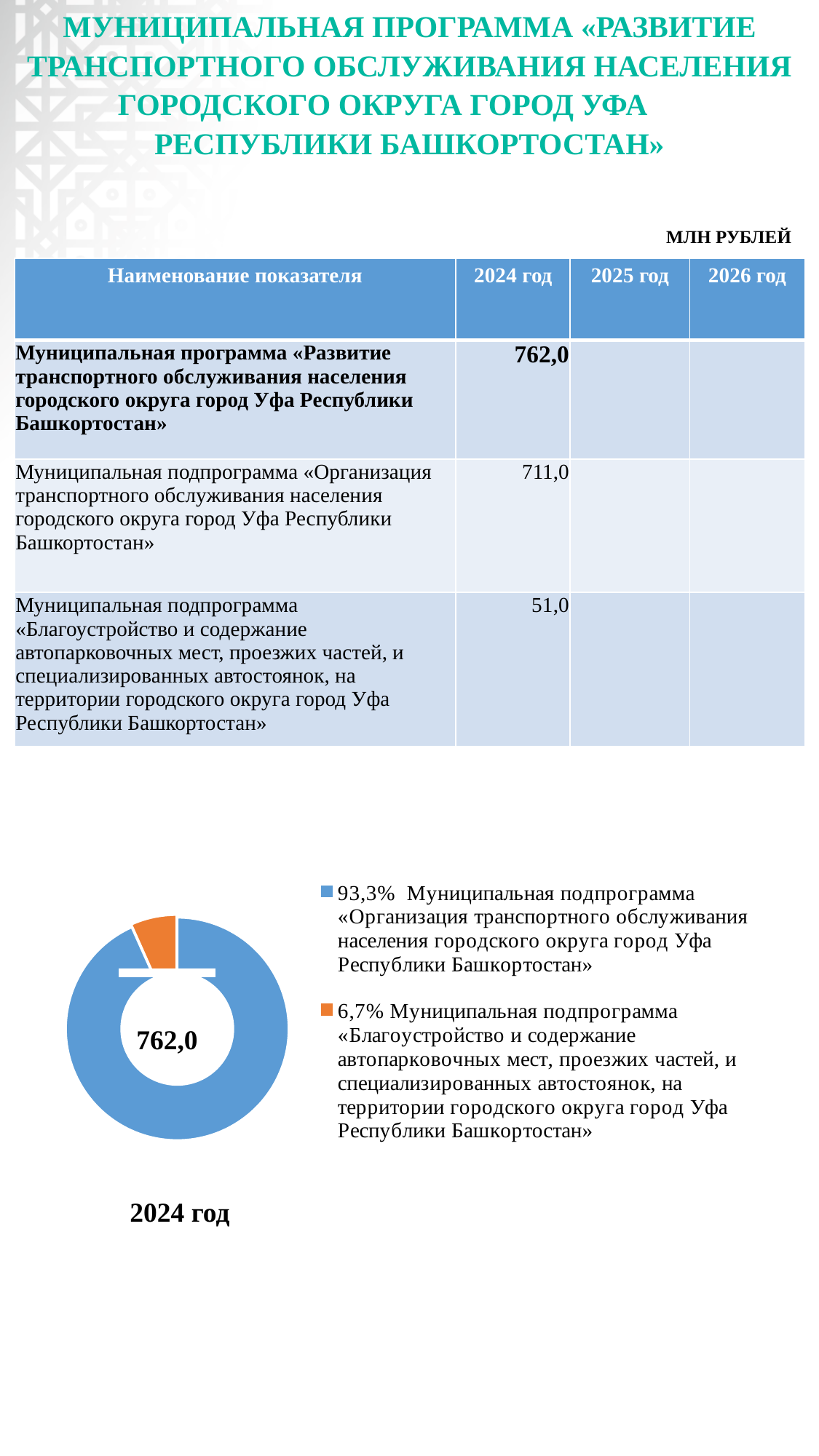
Which slice of the pie chart is the largest? Муниципальная подпрограмма «Организация транспортного обслуживания населения городского округа город Уфа Республики Башкортостан» What share of the pie does the subprogram «Благоустройство и содержание автопарковочных мест, проезжих частей, и специализированных автостоянок, на территории городского округа город Уфа Республики Башкортостан» have? 6,7% How many entries does the pie chart's legend list? 2 Which year does the pie chart represent, according to the label beneath it? 2024 год Which slice of the pie chart is the smallest? Муниципальная подпрограмма «Благоустройство и содержание автопарковочных мест, проезжих частей, и специализированных автостоянок, на территории городского округа город Уфа Республики Башкортостан» How many slices does the pie chart have? 2 What total value is printed in the centre of the pie chart? 762,0 What share of the pie does the subprogram «Организация транспортного обслуживания населения городского округа город Уфа Республики Башкортостан» have? 93,3% What kind of chart is shown on the slide? Pie chart (doughnut) Which is larger in the pie chart: the share for «Организация транспортного обслуживания...» or the share for «Благоустройство и содержание автопарковочных мест...»? «Организация транспортного обслуживания...» What is the difference in percentage points between the two slices of the pie chart? 86,6% What colour is the slice for the subprogram «Благоустройство и содержание автопарковочных мест...» in the pie chart? Orange